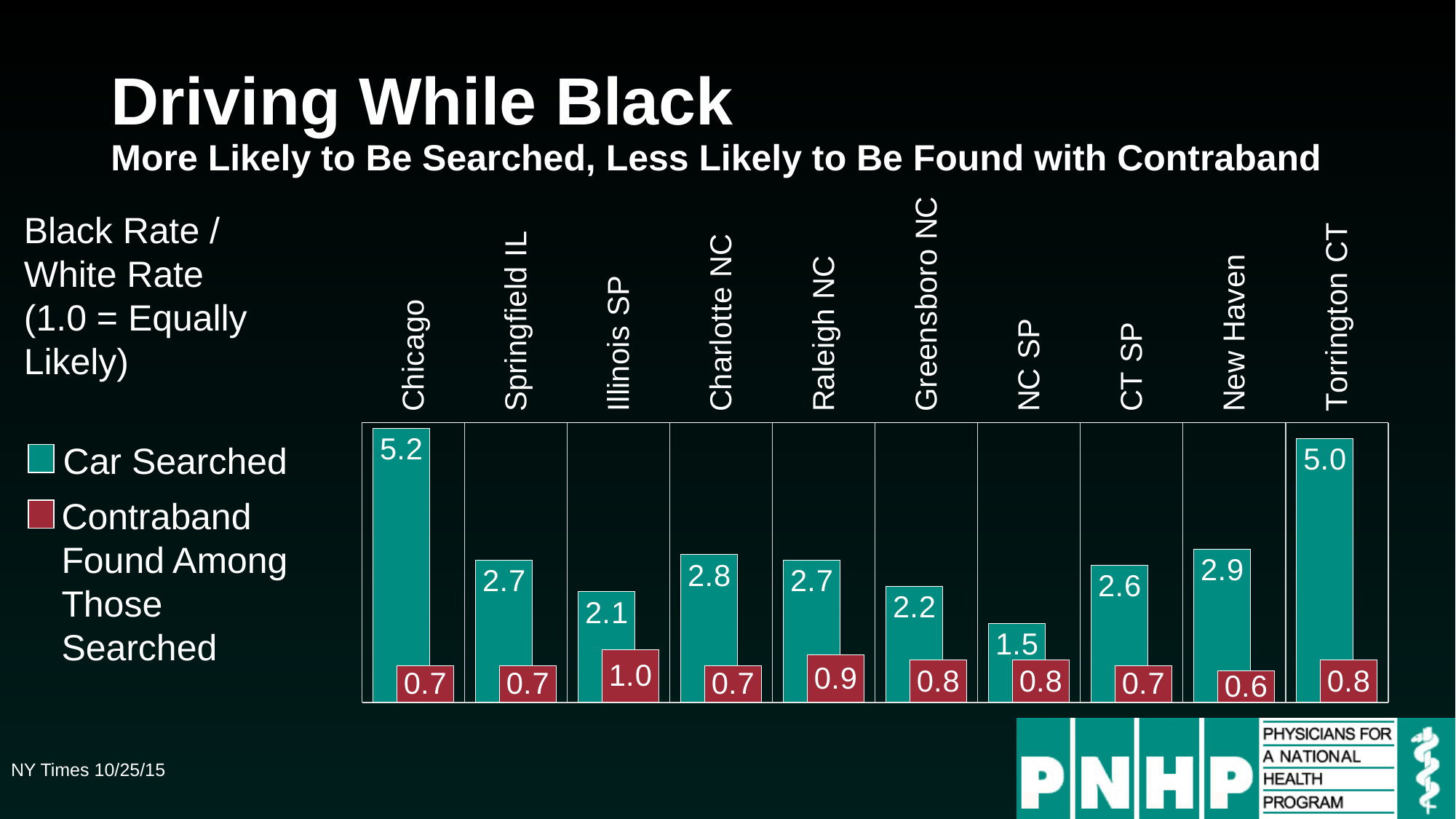
What is the Contraband Found Among Those Searched value for Illinois SP? 1.0 Which location has the lowest Car Searched value? NC SP What is the Car Searched value for New Haven? 2.9 Which is larger, the Car Searched value for Charlotte NC or for Greensboro NC? Charlotte NC Which location has the highest Car Searched value? Chicago Which location has the lowest Contraband Found Among Those Searched value? New Haven How many series does the legend list? 2 What is the difference between the Car Searched value and the Contraband Found value for Torrington CT? 4.2 What colour are the Car Searched bars? teal How many locations are shown on the chart? 10 What is the Car Searched value for Chicago? 5.2 What kind of chart is shown on the slide? bar chart